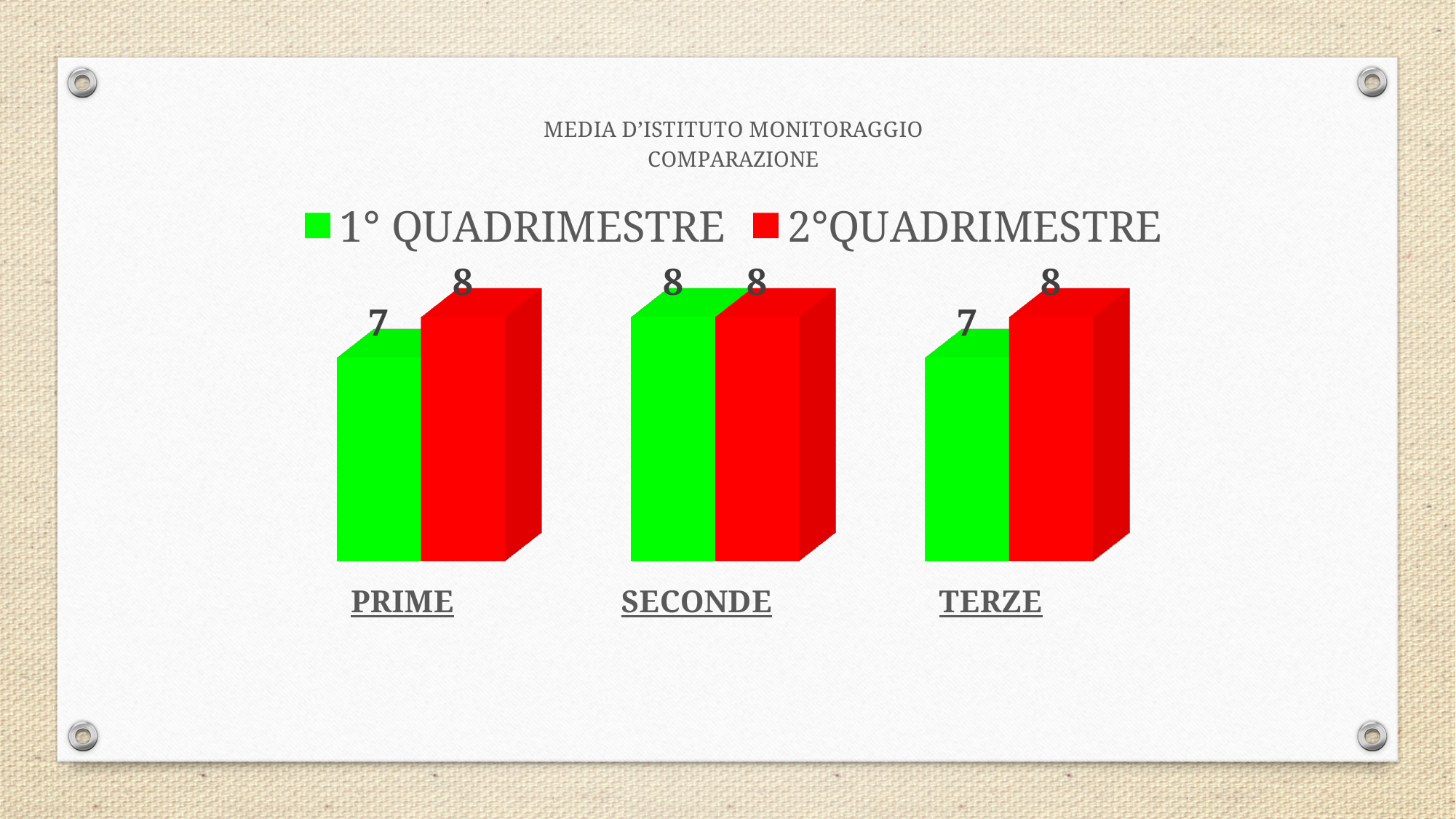
What is the value for TERZE in the 1° QUADRIMESTRE series? 7 For TERZE, which series has the larger value, 1° QUADRIMESTRE or 2°QUADRIMESTRE? 2°QUADRIMESTRE What is the value for SECONDE in the 1° QUADRIMESTRE series? 8 What is the value for PRIME in the 1° QUADRIMESTRE series? 7 What is the difference between the 2°QUADRIMESTRE and 1° QUADRIMESTRE values for PRIME? 1 Which colour represents the 2°QUADRIMESTRE series? Red What kind of chart is shown on the slide? Bar chart What is the value for PRIME in the 2°QUADRIMESTRE series? 8 How many categories are shown on the x axis? 3 How many series does the legend list? 2 What is the value for TERZE in the 2°QUADRIMESTRE series? 8 What is the difference between the 1° QUADRIMESTRE and 2°QUADRIMESTRE values for SECONDE? 0